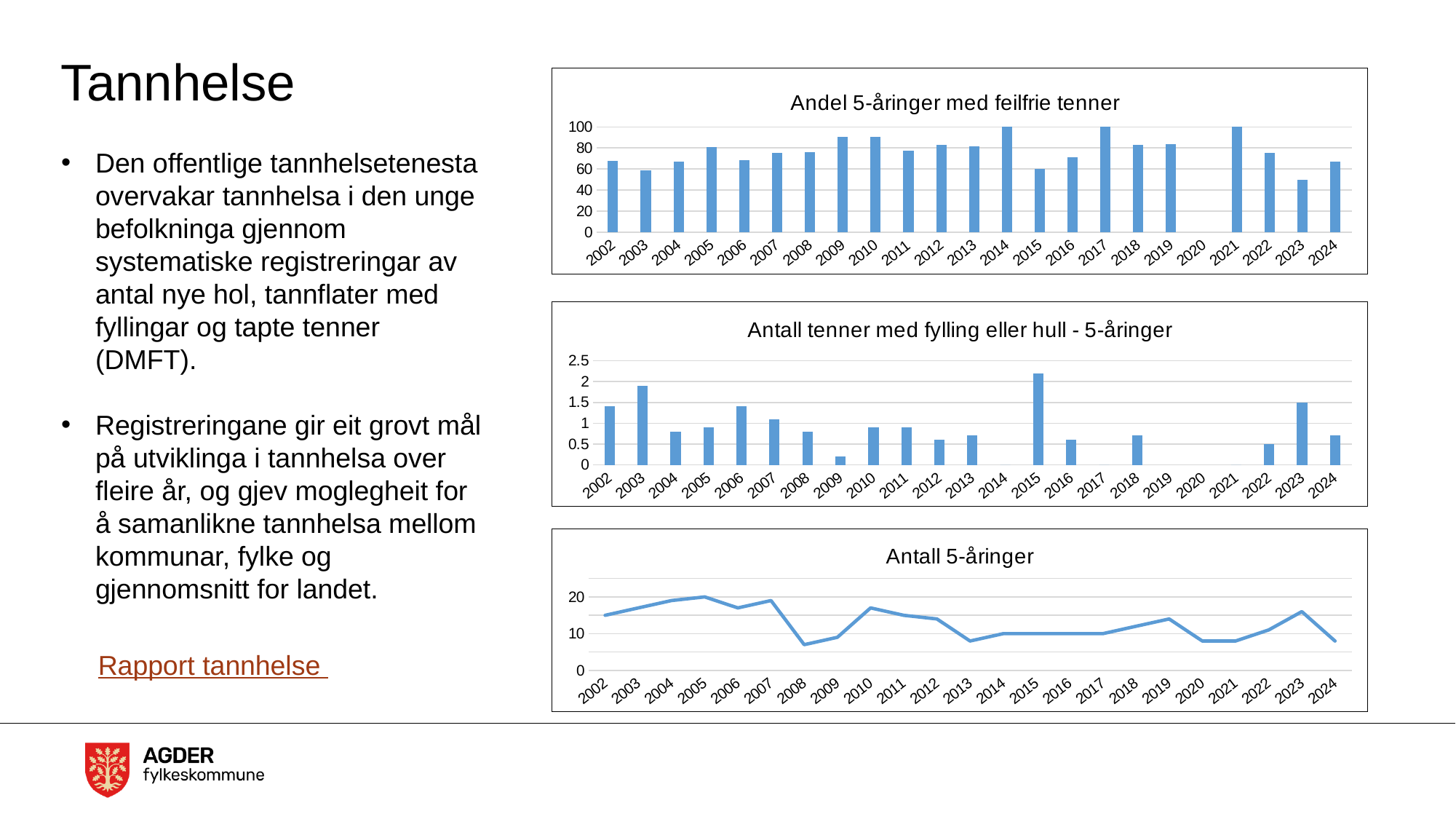
In the bottom chart 'Antall 5-åringer', which is larger, the value for 2005 or the value for 2024? 2005 In the bottom chart 'Antall 5-åringer', is the value for 2008 greater or less than 10? less In the top chart 'Andel 5-åringer med feilfrie tenner', which is larger, the value for 2014 or the value for 2015? 2014 How many years are shown on the x axis of the top chart 'Andel 5-åringer med feilfrie tenner'? 23 In the middle chart 'Antall tenner med fylling eller hull - 5-åringer', which year has the highest value? 2015 In the top chart 'Andel 5-åringer med feilfrie tenner', is the value for 2023 greater or less than 60? less In the middle chart 'Antall tenner med fylling eller hull - 5-åringer', is the value for 2023 greater or less than 1? greater In the top chart 'Andel 5-åringer med feilfrie tenner', what is the value for 2014? 100 What kind of chart is the top chart, 'Andel 5-åringer med feilfrie tenner'? bar chart What kind of chart is the bottom chart, 'Antall 5-åringer'? line chart